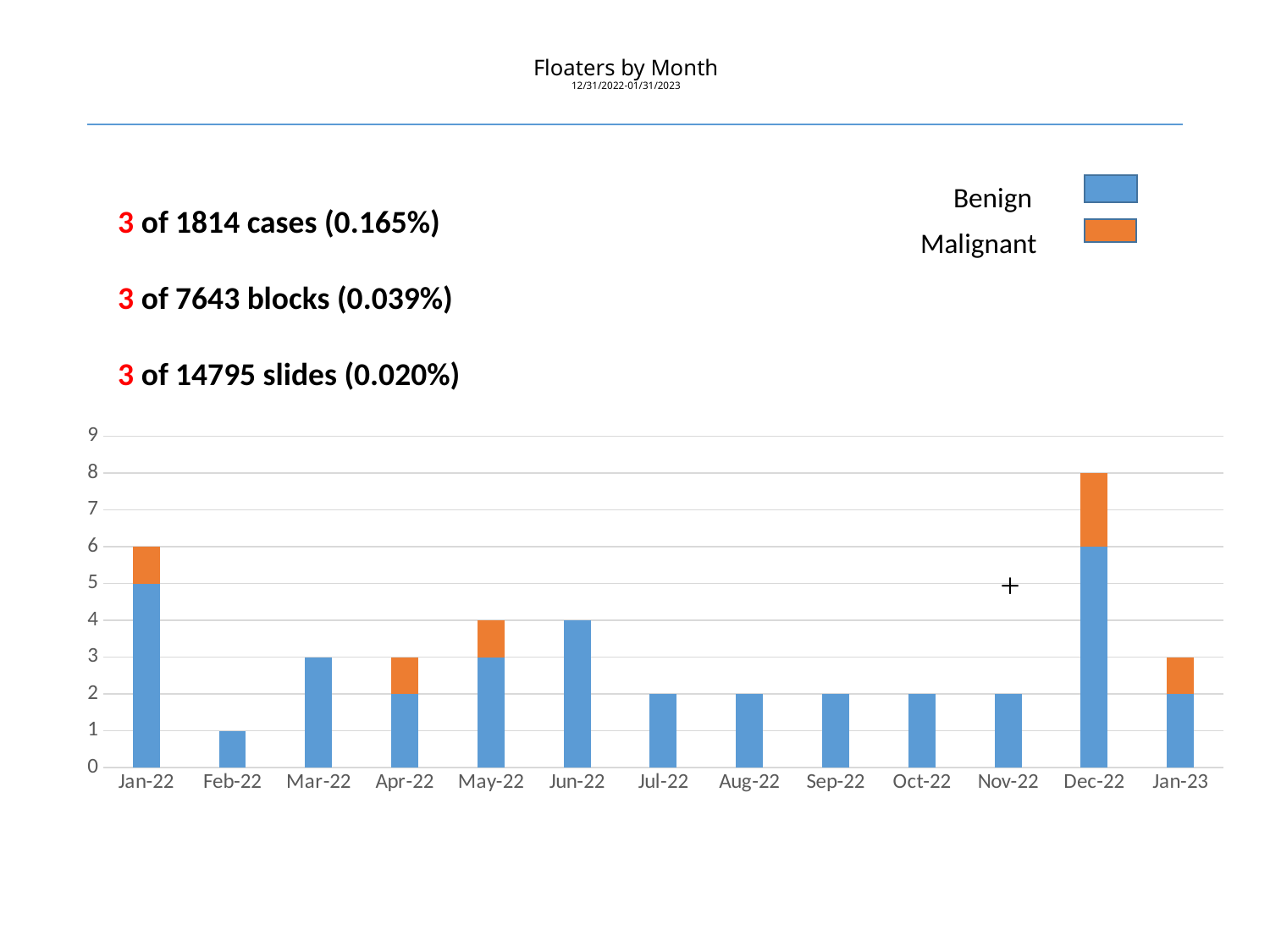
Which series is shown in orange in the chart legend? Malignant What is the Malignant value for Dec-22? 2 Which month has the highest total bar in the chart? Dec-22 Is the total for Jun-22 larger than the total for Mar-22? Yes What is the total height of the stacked bar for Dec-22? 8 What kind of chart is shown on the slide? stacked bar chart How many months are shown on the x axis of the chart? 13 Which month has the lowest total bar in the chart? Feb-22 What is the Benign value for Jan-22? 5 How many series does the chart legend list? 2 What is the total height of the stacked bar for Jan-22? 6 What is the difference between the Benign values for Dec-22 and Jan-23? 4